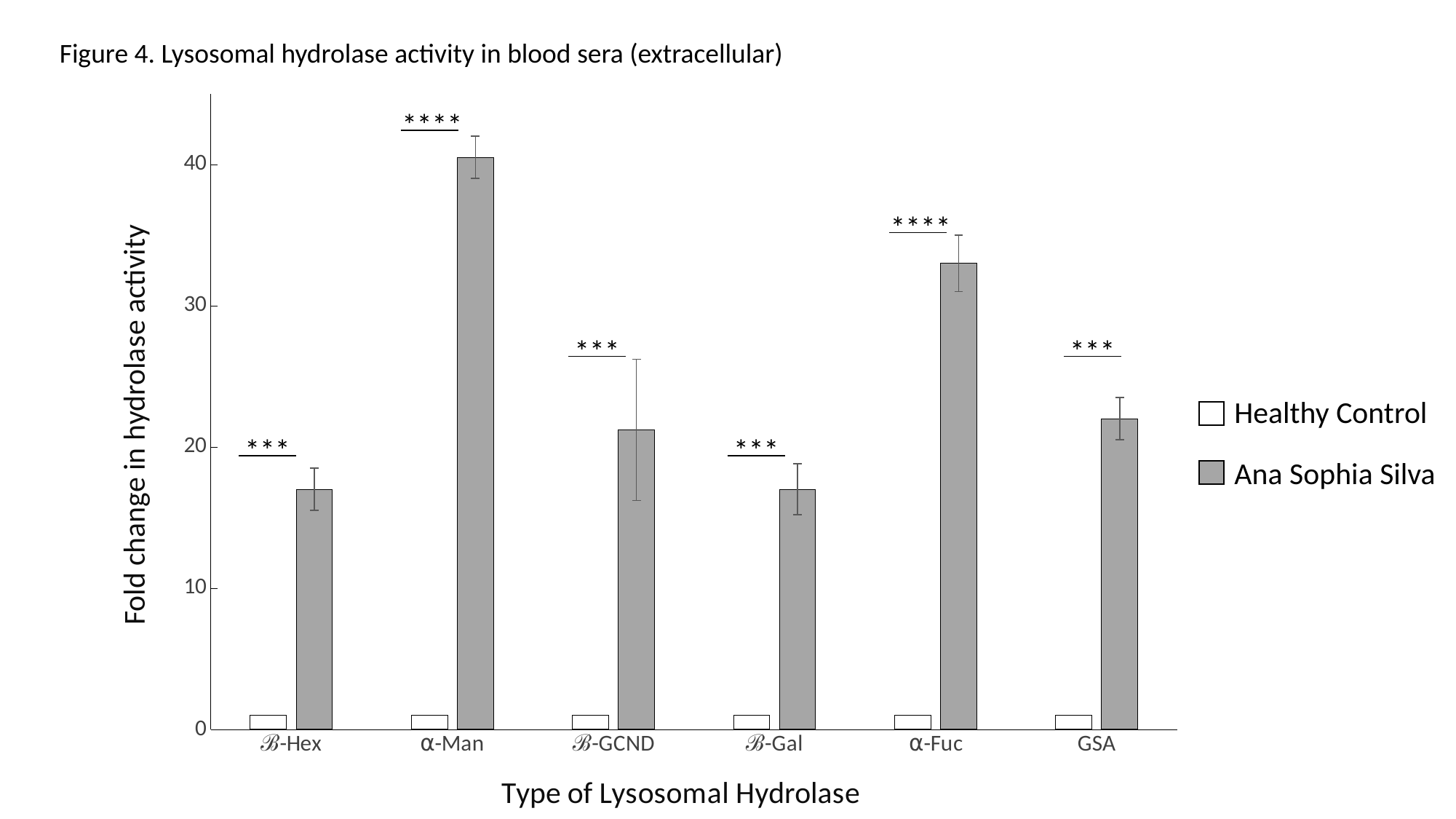
Which is larger for Ana Sophia Silva, the value for α-Fuc or the value for GSA? α-Fuc What kind of chart is shown on the slide? bar chart How many types of lysosomal hydrolase are shown on the x axis? 6 Is the Ana Sophia Silva value for β-GCND greater or less than 30? less What is the title of the y axis? Fold change in hydrolase activity Which hydrolase has the highest fold change in activity for Ana Sophia Silva? α-Man Is the Ana Sophia Silva value for α-Fuc greater or less than 30? greater How many series does the legend list? 2 Which is larger for Ana Sophia Silva, the value for β-Gal or the value for α-Man? α-Man Is the Ana Sophia Silva value for β-Hex greater or less than 20? less